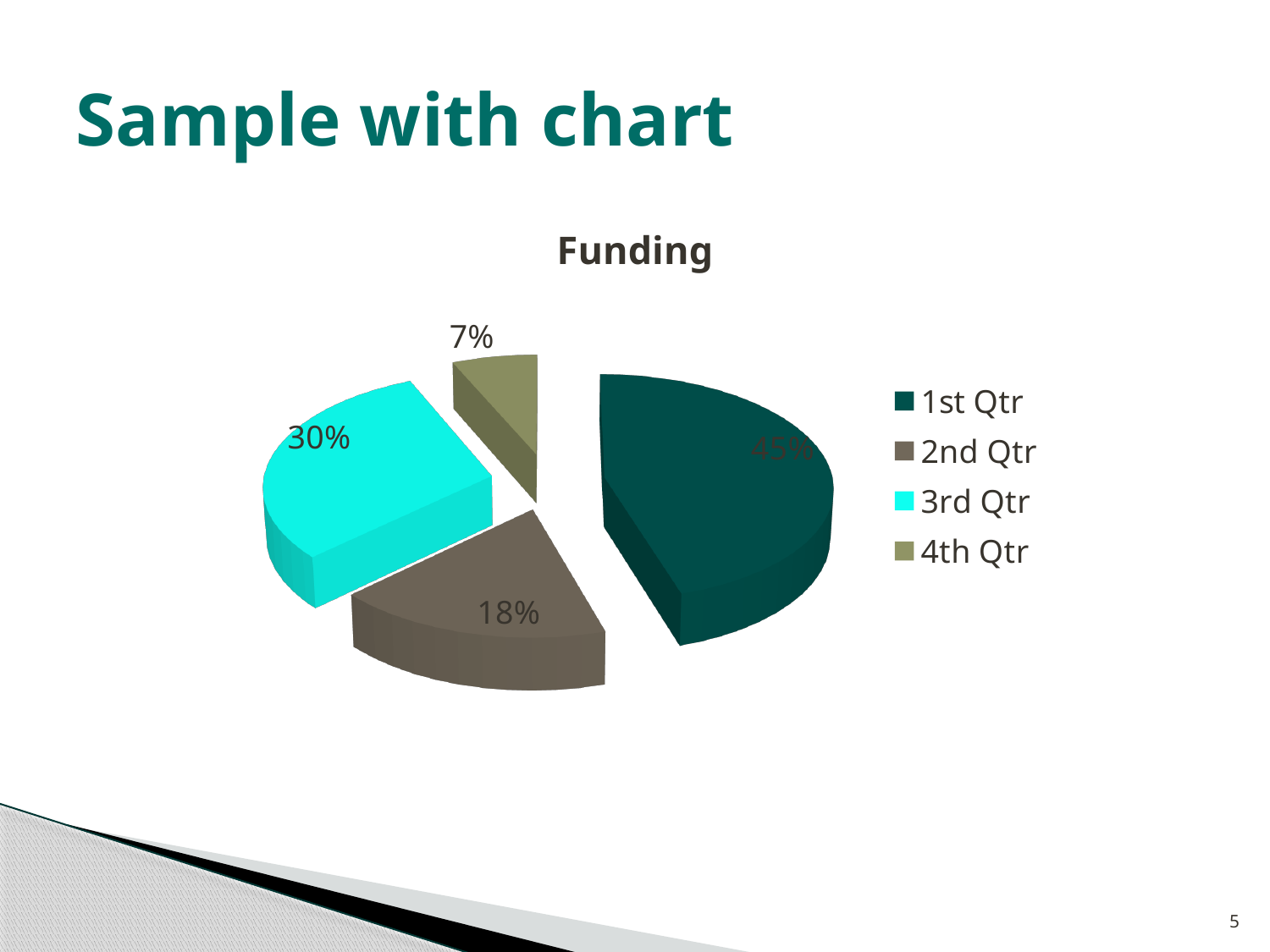
Which is larger, the share for 2nd Qtr or the share for 3rd Qtr? 3rd Qtr How many slices does the pie chart have? 4 What share of the pie does 1st Qtr have? 45% What share of the pie does 3rd Qtr have? 30% What type of chart is shown on the slide? Pie chart Which quarter has the largest share of the pie? 1st Qtr What share of the pie does 4th Qtr have? 7% How many entries does the legend list? 4 What is the title of the chart? Funding Which quarter has the smallest share of the pie? 4th Qtr What is the difference in percentage points between the 1st Qtr and 3rd Qtr shares? 15%